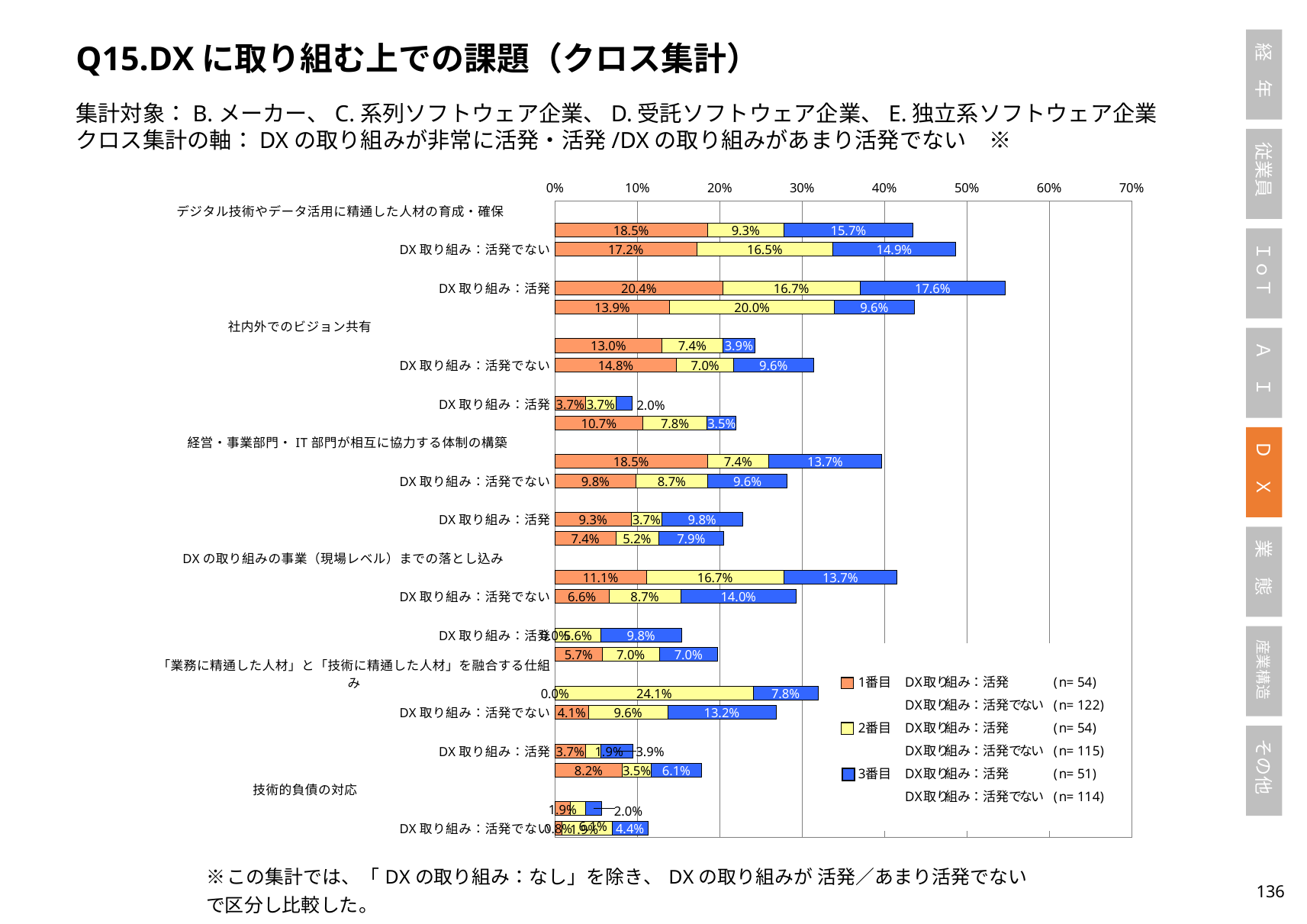
According to the legend, what is the n for 1番目 DX取り組み：活発でない? n= 122 What kind of chart is shown on the slide? Stacked horizontal bar chart What is the 1番目 value printed on the topmost bar of the chart? 18.5% What is the total of the three segments of the topmost bar (18.5%, 9.3%, 15.7%)? 43.5% What is the largest single segment value printed anywhere on the chart? 24.1% How many series does the chart legend list? 3 What are the three series names shown in the legend? 1番目, 2番目, 3番目 On the topmost bar, how much larger is the 1番目 segment (18.5%) than the 2番目 segment (9.3%)? 9.2 percentage points What is the highest value shown on the x axis? 70% Is the total length of the third bar from the top (20.4%, 16.7%, 17.6%) greater or less than 50%? greater Which is longer in total, the topmost bar or the second bar from the top? The second bar from the top According to the legend, what is the n for 3番目 DX取り組み：活発でない? n= 114